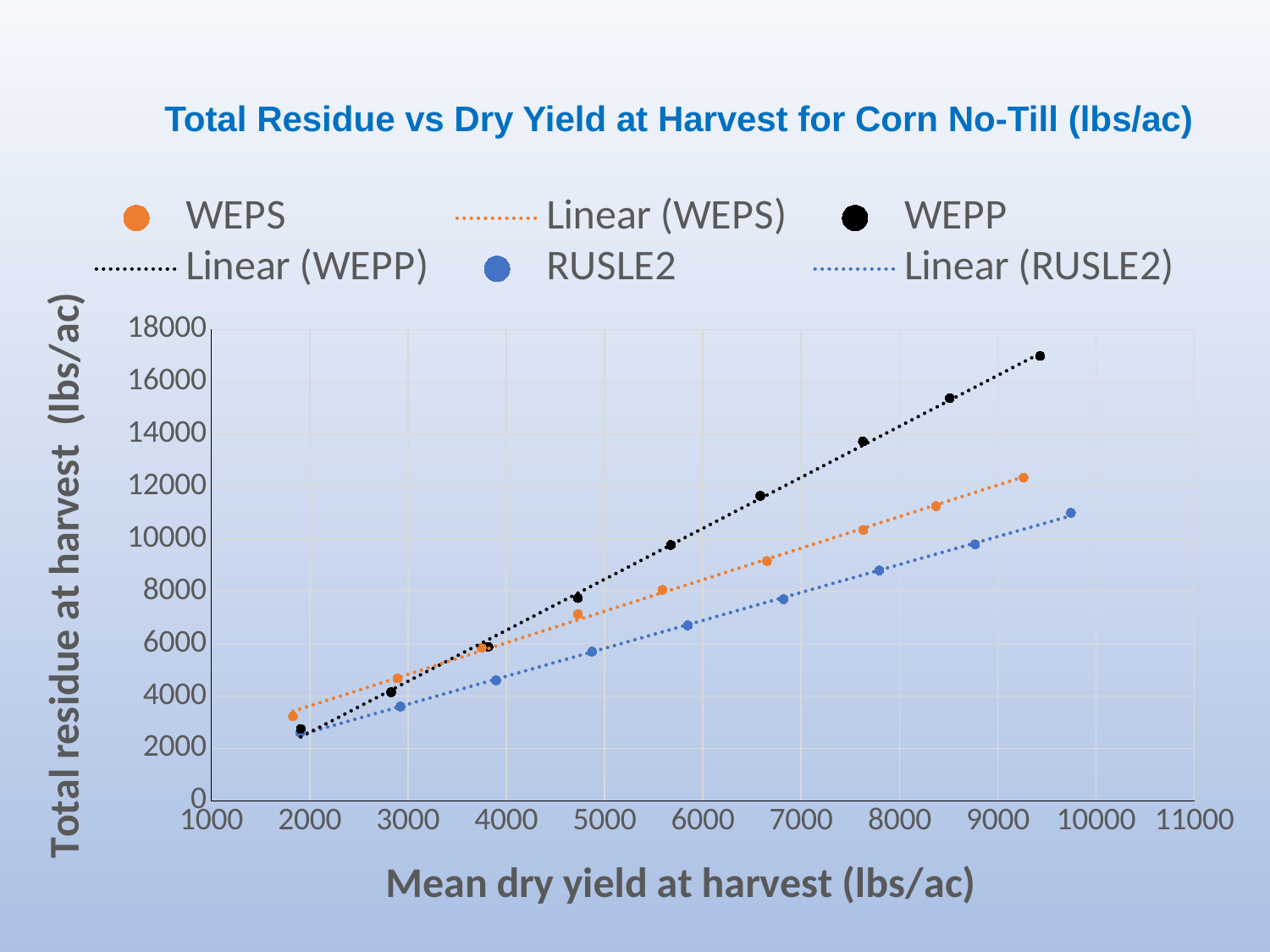
Is the highest RUSLE2 point greater or less than 12000 lbs/ac? less Do the WEPP values rise or fall as mean dry yield increases? Rise What is the title of the chart? Total Residue vs Dry Yield at Harvest for Corn No-Till (lbs/ac) What is the label of the x axis? Mean dry yield at harvest (lbs/ac) Is the highest WEPP point greater or less than 16000 lbs/ac? greater Which series reaches the highest total residue value on the chart? WEPP Is the highest WEPS point greater or less than 10000 lbs/ac? greater Which series has the lowest total residue values at high yields (above 8000 lbs/ac)? RUSLE2 At a mean dry yield of about 9000 lbs/ac, which series has the larger total residue, WEPP or WEPS? WEPP What kind of chart is shown on the slide? Scatter chart Which series has the steepest linear trendline? WEPP How many entries does the legend list? 6